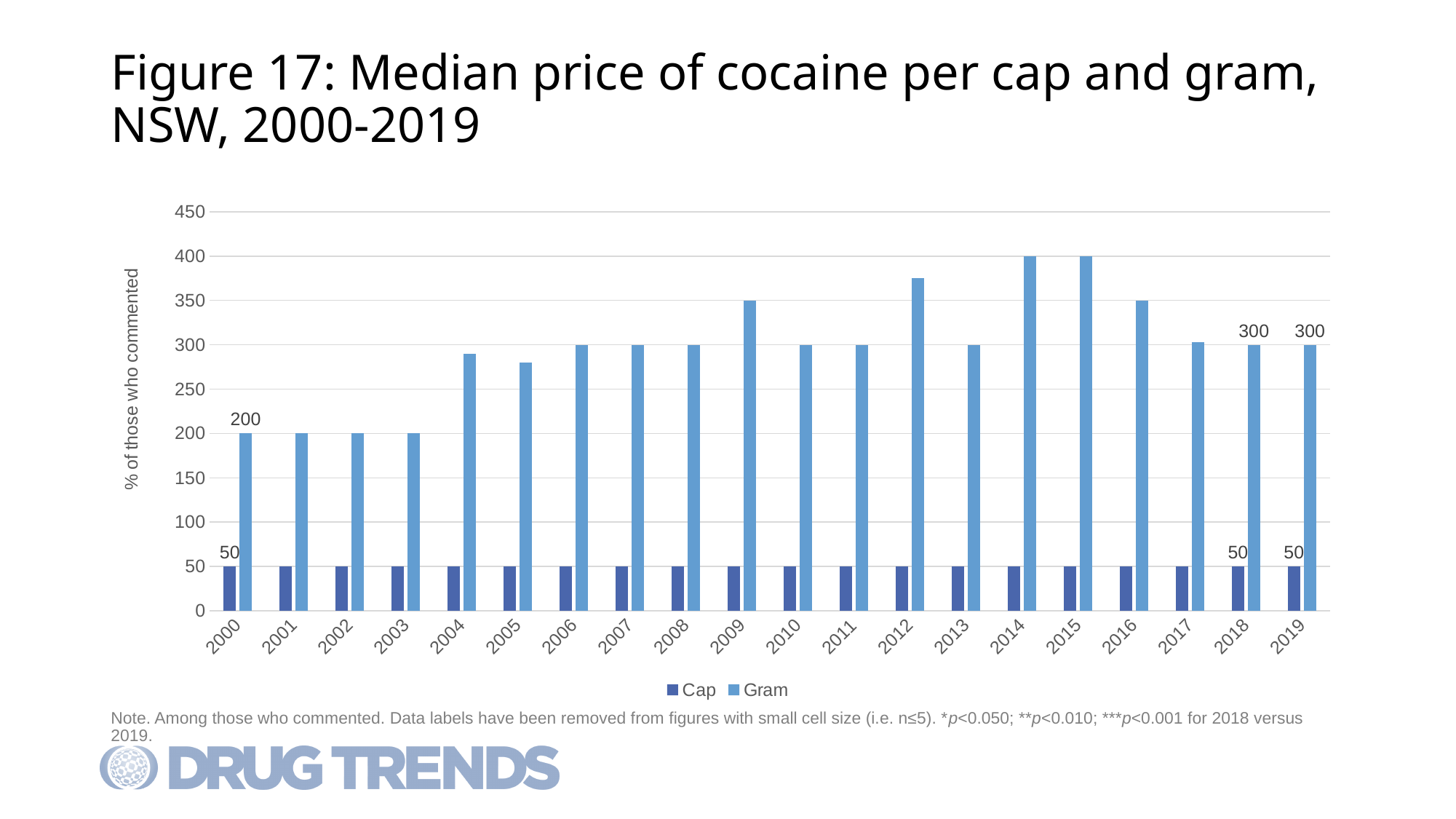
What is the difference between the Gram value and the Cap value in 2019? 250 Is the Gram value for 2014 greater or less than 350? greater Is the Gram value for 2005 greater or less than 250? greater By how much did the Gram value increase from 2000 to 2018? 100 What is the Cap value for 2018? 50 What is the Gram value for 2019? 300 Which is larger in 2000, the Cap value or the Gram value? Gram How many series does the legend list? 2 Is the Gram value for 2002 greater or less than 250? less What kind of chart is shown on the slide? Bar chart How many years are shown on the x axis? 20 What is the Gram value for 2000? 200